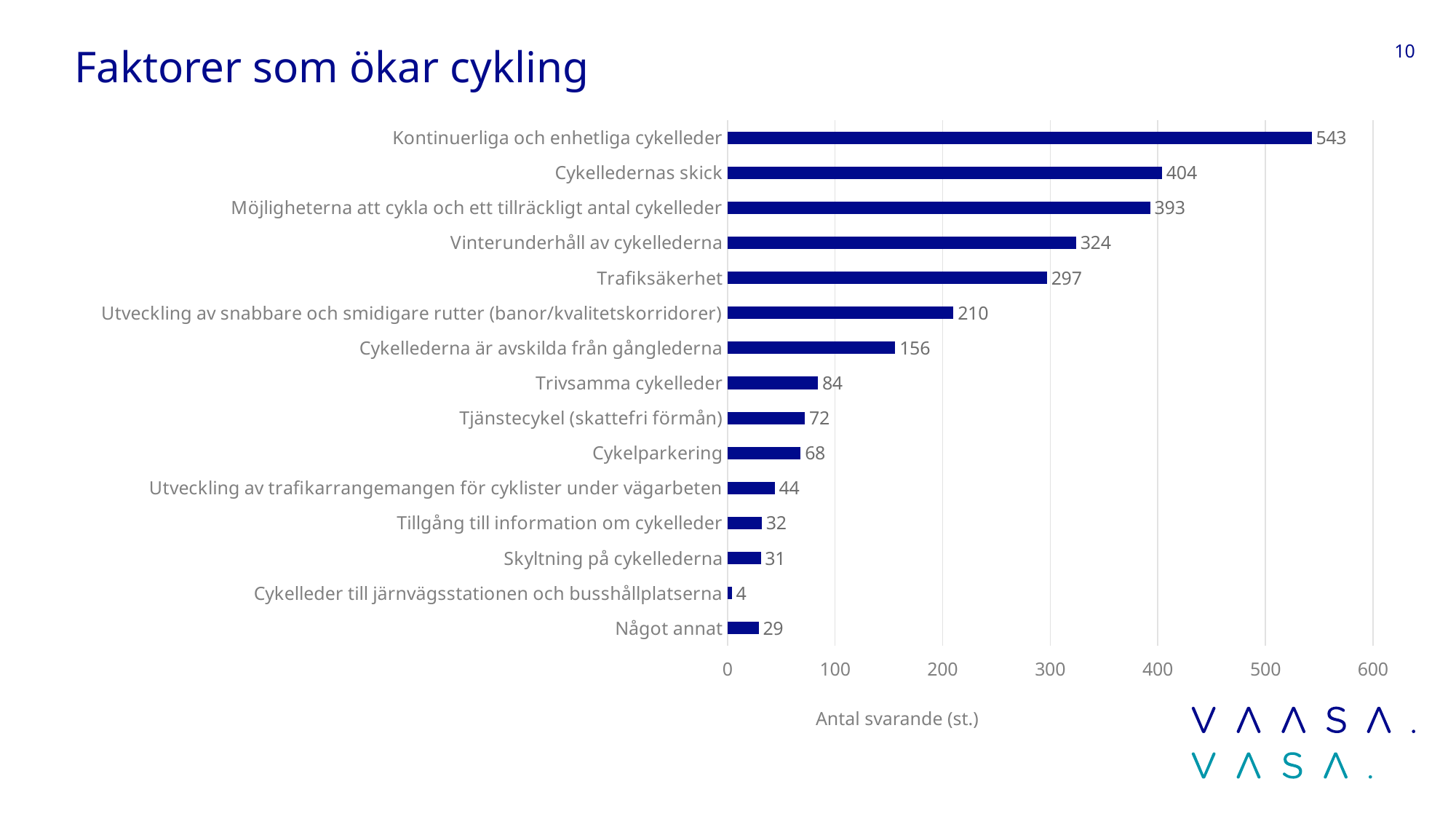
What is the label of the horizontal axis? Antal svarande (st.) Is the value for "Utveckling av snabbare och smidigare rutter (banor/kvalitetskorridorer)" greater or less than 200? greater Which is larger, "Trivsamma cykelleder" or "Tjänstecykel (skattefri förmån)"? Trivsamma cykelleder Which category has the highest value? Kontinuerliga och enhetliga cykelleder Which category has the lowest value? Cykelleder till järnvägsstationen och busshållplatserna What is the difference between "Cykelledernas skick" and "Vinterunderhåll av cykellederna"? 80 How many categories are shown in the chart? 15 What kind of chart is shown on the slide? Bar chart What is the value for "Cykelparkering"? 68 What is the title of the slide? Faktorer som ökar cykling What is the value for "Trafiksäkerhet"? 297 What is the value for "Kontinuerliga och enhetliga cykelleder"? 543